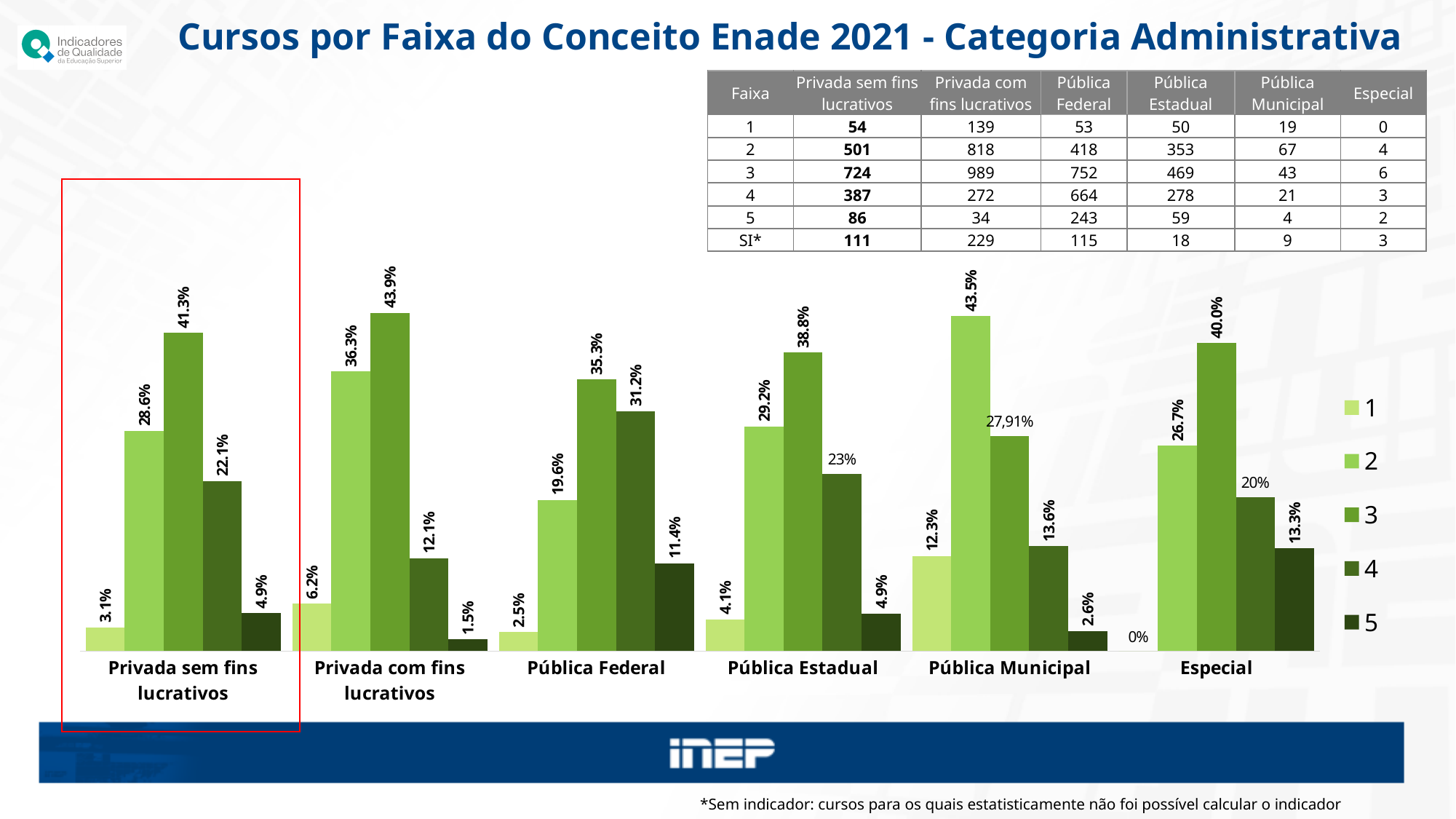
Which series has the highest value in the Pública Municipal category? 2 What is the value for series 3 in the Privada sem fins lucrativos category? 41.3% What is the value for series 2 in the Pública Municipal category? 43.5% What is the difference between the series 3 and series 4 values in the Pública Federal category? 4.1% How many categories are shown along the x axis of the chart? 6 Which is larger: the series 2 value for Privada com fins lucrativos or the series 2 value for Pública Estadual? Privada com fins lucrativos Which series has the lowest value in the Privada com fins lucrativos category? 5 What is the value for series 1 in the Especial category? 0% Which category is highlighted with a red box on the slide? Privada sem fins lucrativos What kind of chart is shown on the slide? bar chart What is the value for series 5 in the Pública Federal category? 11.4% How many series does the chart legend list? 5